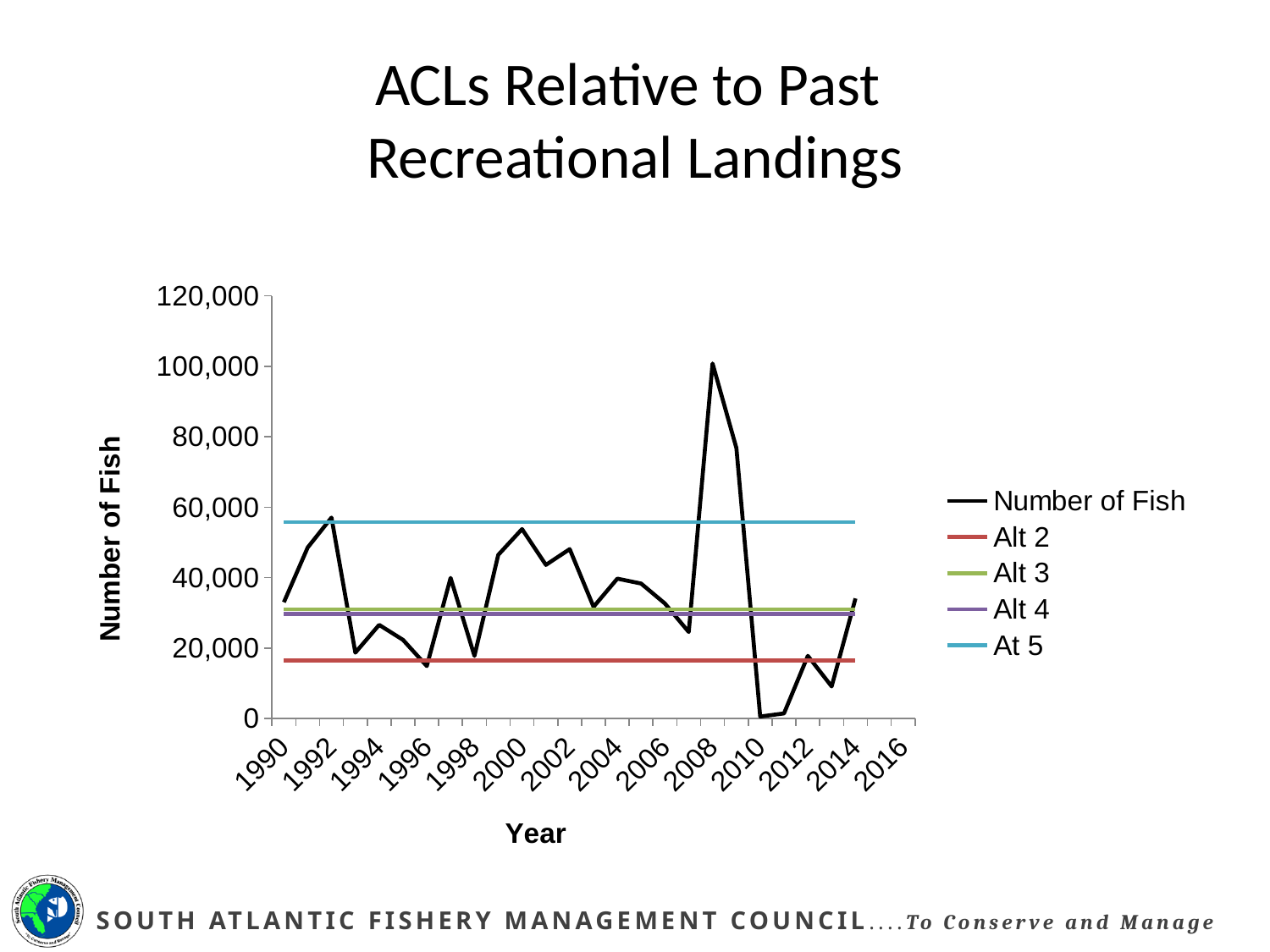
Which of the horizontal ACL lines (Alt 2, Alt 3, Alt 4, At 5) is the highest? At 5 Is the At 5 line greater or less than 40,000? greater How many series does the legend list? 5 Which is larger, the At 5 line or the Alt 2 line? At 5 What kind of chart is shown on the slide? line chart What is the title of the vertical axis? Number of Fish Does the Number of Fish line rise or fall between 2008 and 2010? fall Is the Number of Fish value for 2008 greater or less than 80,000? greater Is the Number of Fish value for 2010 greater or less than 20,000? less In which year does the Number of Fish line reach its highest value? 2008 Which of the horizontal ACL lines (Alt 2, Alt 3, Alt 4, At 5) is the lowest? Alt 2